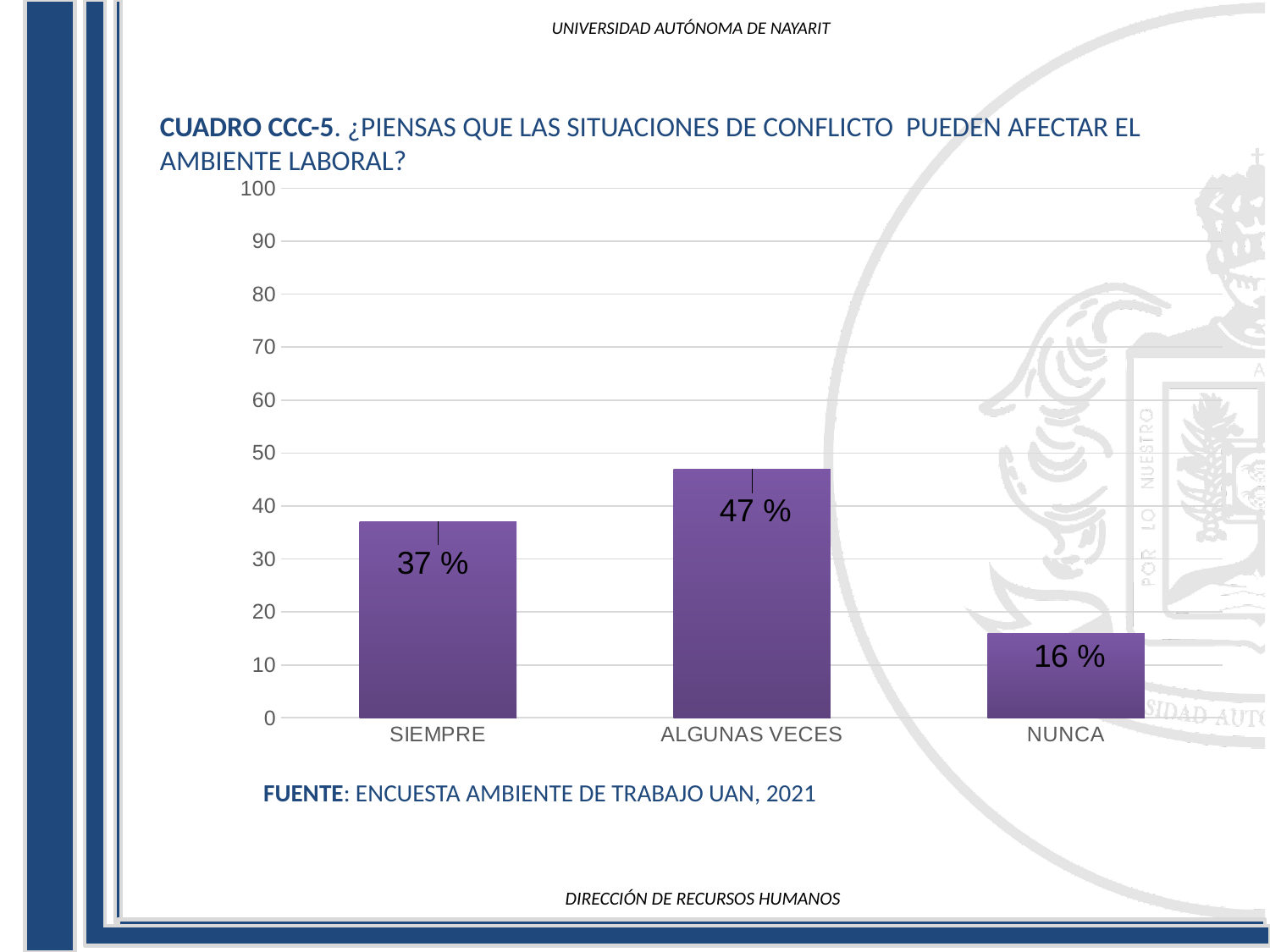
What is the value for SIEMPRE? 37 % What is the difference between the values for SIEMPRE and NUNCA? 21 % What is the value for ALGUNAS VECES? 47 % Which is larger, the value for SIEMPRE or the value for NUNCA? SIEMPRE Which category has the highest value? ALGUNAS VECES What is the value for NUNCA? 16 % How many categories are shown on the x axis? 3 What kind of chart is shown on the slide? bar chart What is the difference between the values for ALGUNAS VECES and SIEMPRE? 10 % What is the source cited below the chart? ENCUESTA AMBIENTE DE TRABAJO UAN, 2021 Which category has the lowest value? NUNCA Is the value for ALGUNAS VECES greater or less than 50? less